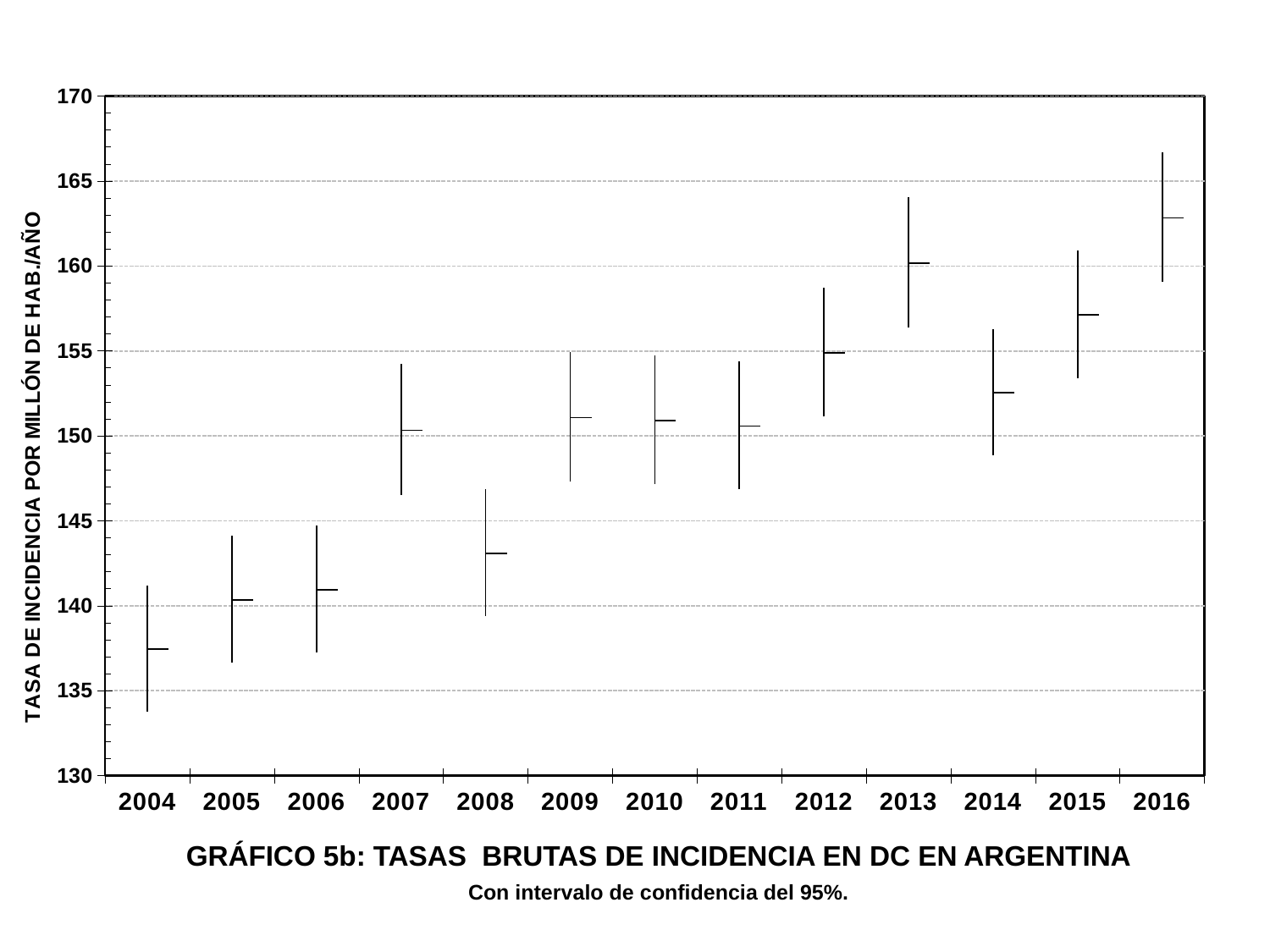
Which year has a higher incidence rate, 2007 or 2008? 2007 Is the incidence rate for 2008 greater or less than 145? less What confidence interval level does the chart subtitle state? 95% Is the incidence rate for 2004 greater or less than 140? less Do the incidence rates generally rise or fall from 2004 to 2016? rise Is the incidence rate for 2014 greater or less than 150? greater Which year has the highest incidence rate in the chart? 2016 Which year has the lowest incidence rate in the chart? 2004 How many years are shown on the x axis of the chart? 13 Which year has a higher incidence rate, 2013 or 2014? 2013